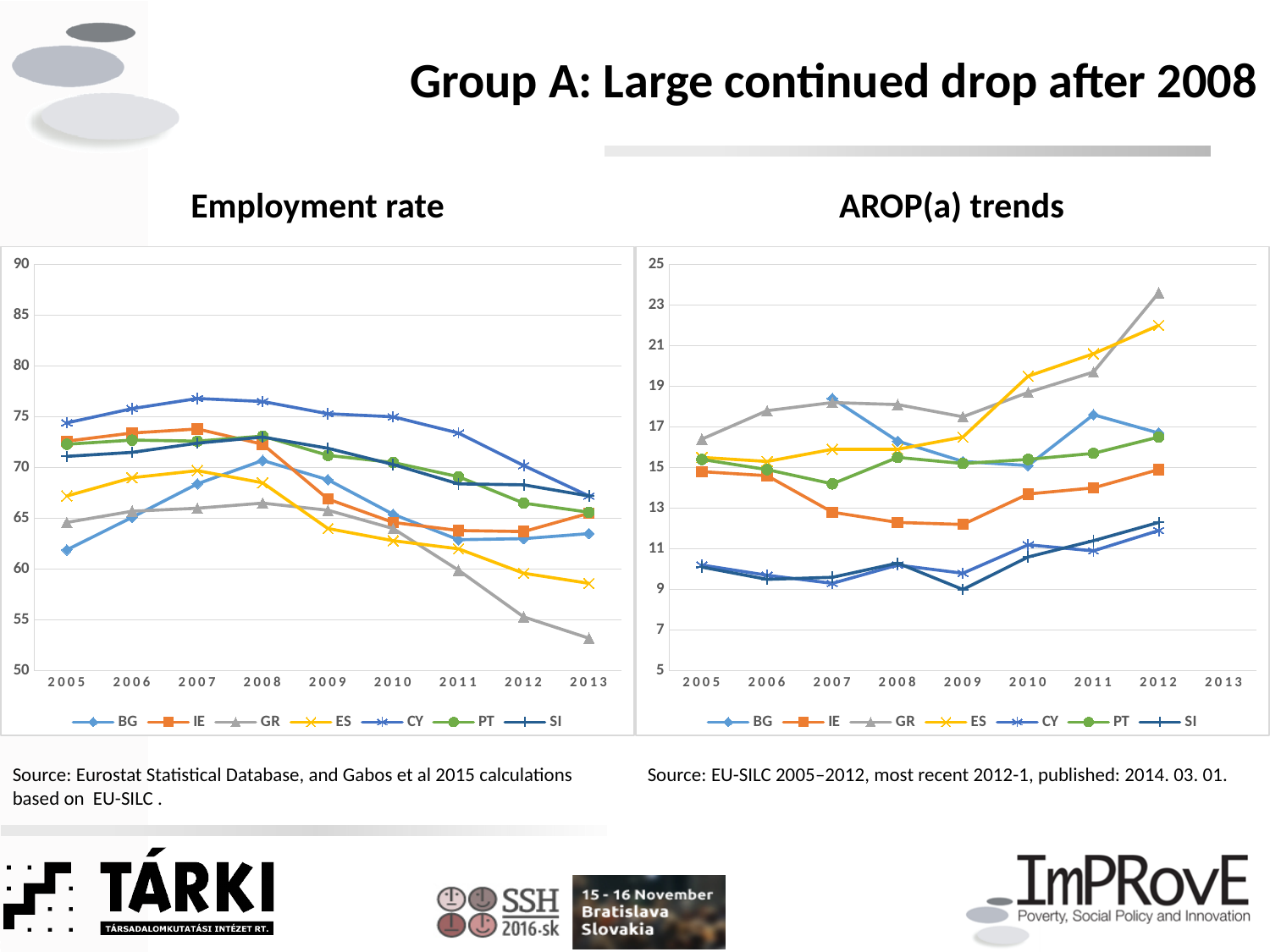
In the Employment rate chart, does the GR line rise or fall from 2008 to 2013? fall How many years are shown on the x axis of the Employment rate chart? 9 In the Employment rate chart, which country has the lowest value in 2013? GR In the AROP(a) trends chart, which country has the highest value in 2012? GR In the AROP(a) trends chart, which is larger in 2012, IE or PT? PT How many series does the legend of the AROP(a) trends chart list? 7 In the AROP(a) trends chart, is the value for ES in 2012 greater or less than 21? greater In the Employment rate chart, which country has the highest value in 2007? CY In the AROP(a) trends chart, does the GR line rise or fall from 2009 to 2012? rise In the Employment rate chart, is the value for GR in 2013 greater or less than 55? less In the Employment rate chart, is the value for CY in 2013 greater or less than 65? greater What kind of chart is the Employment rate chart? line chart